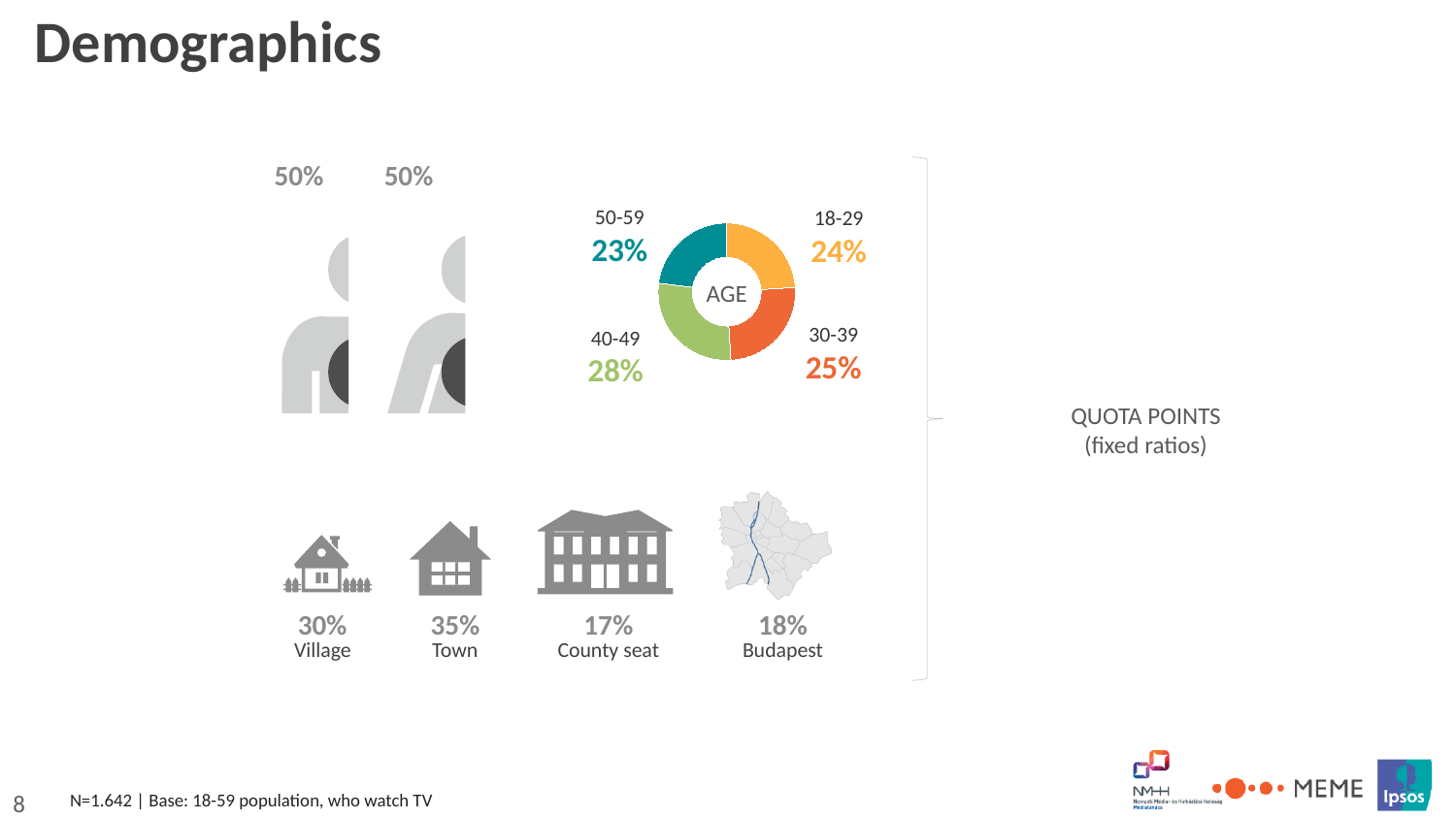
In the AGE donut chart, what is the difference in percentage points between the 40-49 and 50-59 groups? 5 percentage points In the AGE donut chart, which is larger: the share of 30-39 or the share of 18-29? 30-39 In the AGE donut chart, which age group has the smallest share? 50-59 In the AGE donut chart, what colour is the 40-49 slice? Green In the AGE donut chart, what share is the 18-29 age group? 24% How many age groups are shown in the AGE donut chart? 4 In the AGE donut chart, what share is the 50-59 age group? 23% In the AGE donut chart, what share is the 30-39 age group? 25% In the AGE donut chart, which age group has the largest share? 40-49 What type of chart is used to show the age distribution? Donut (pie) chart What label appears in the centre of the donut chart? AGE In the AGE donut chart, what share is the 40-49 age group? 28%